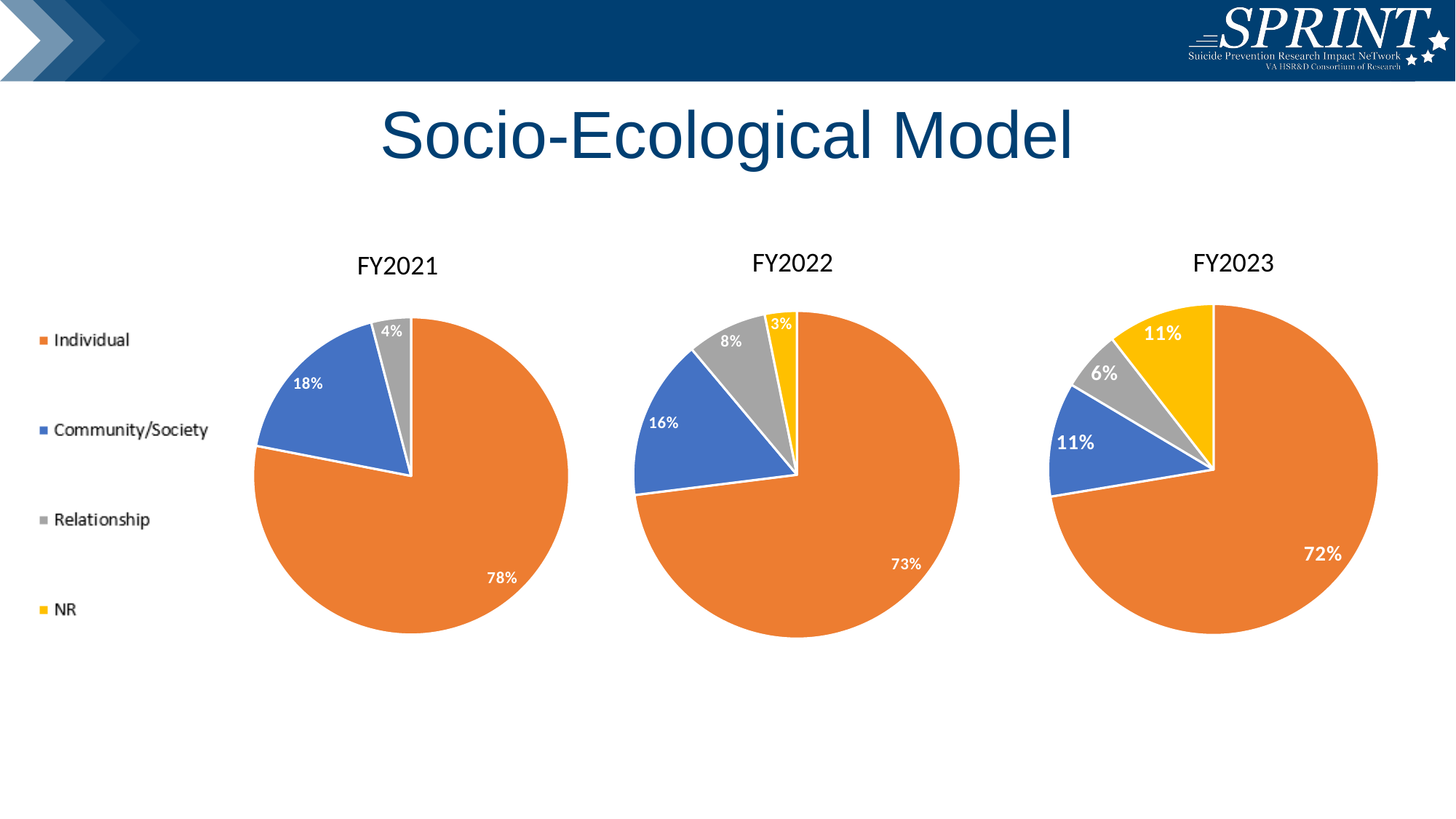
Which colour represents Relationship in the legend? Grey How many categories does the legend list? 4 How many slices does the FY2021 pie chart have? 3 In the FY2021 pie chart, what share does Relationship have? 4% In the FY2022 pie chart, what share does Community/Society have? 16% In the FY2023 pie chart, what share does NR have? 11% In the FY2022 pie chart, which category has the smallest slice? NR What kind of chart is used for FY2022? Pie chart In the FY2023 pie chart, which category has the largest slice? Individual In the FY2021 pie chart, what is the difference between the Individual and Community/Society shares? 60% In the FY2022 pie chart, which is larger, Relationship or NR? Relationship